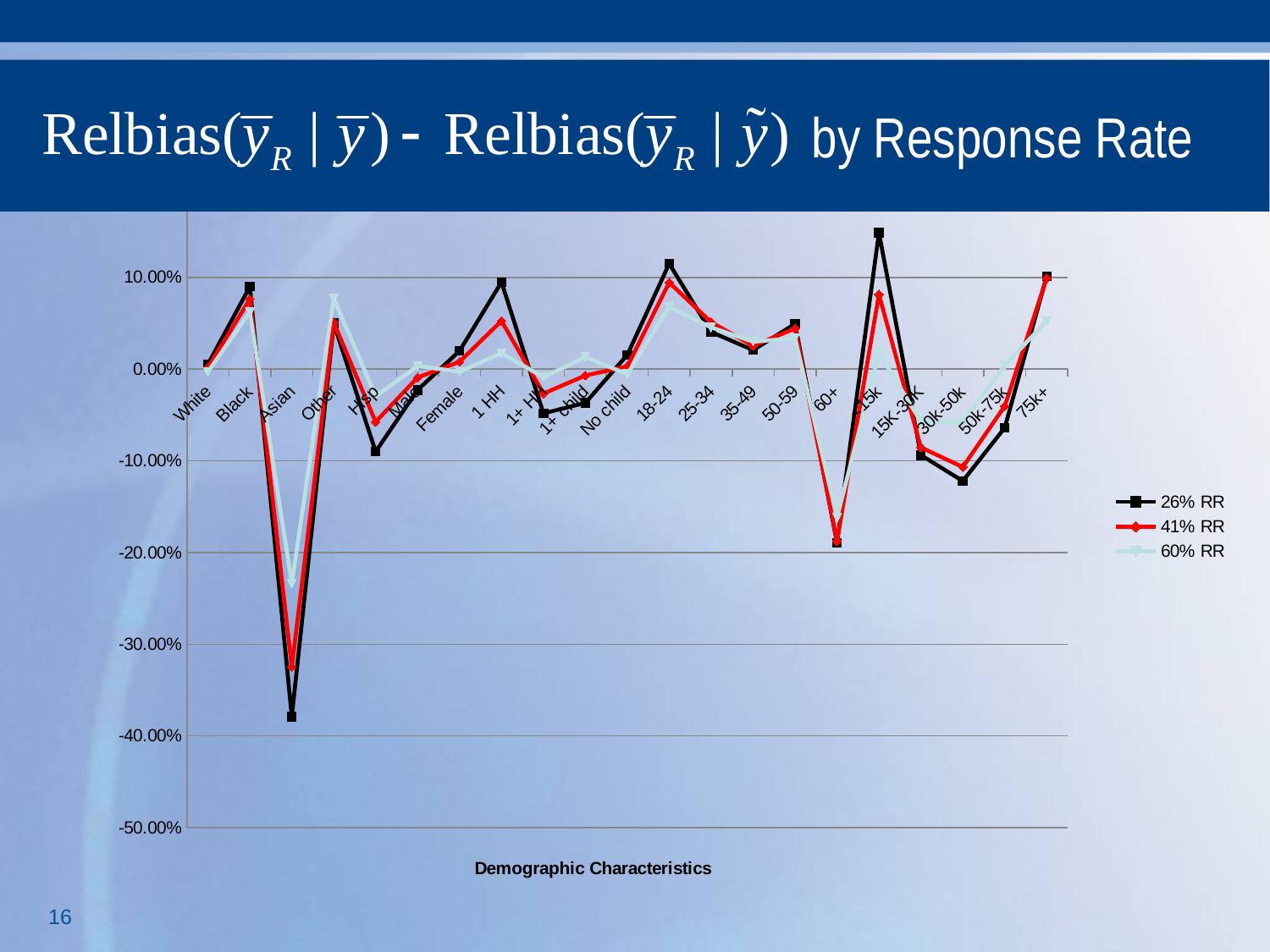
What kind of chart is shown on the slide? line chart Is the value for 18-24 in the 60% RR series greater or less than 10.00%? less At the Asian category, which series has the lower value, 26% RR or 60% RR? 26% RR What is the title of the x axis? Demographic Characteristics What are the three series named in the legend? 26% RR, 41% RR, 60% RR How many demographic categories are plotted along the x axis? 21 How many series does the legend list? 3 For the 26% RR series, which category has the lowest value? Asian Is the value for 60+ in the 26% RR series greater or less than -10.00%? less Is the value for Asian in the 26% RR series greater or less than -30.00%? less At the 1 HH category, which series has the higher value, 26% RR or 60% RR? 26% RR